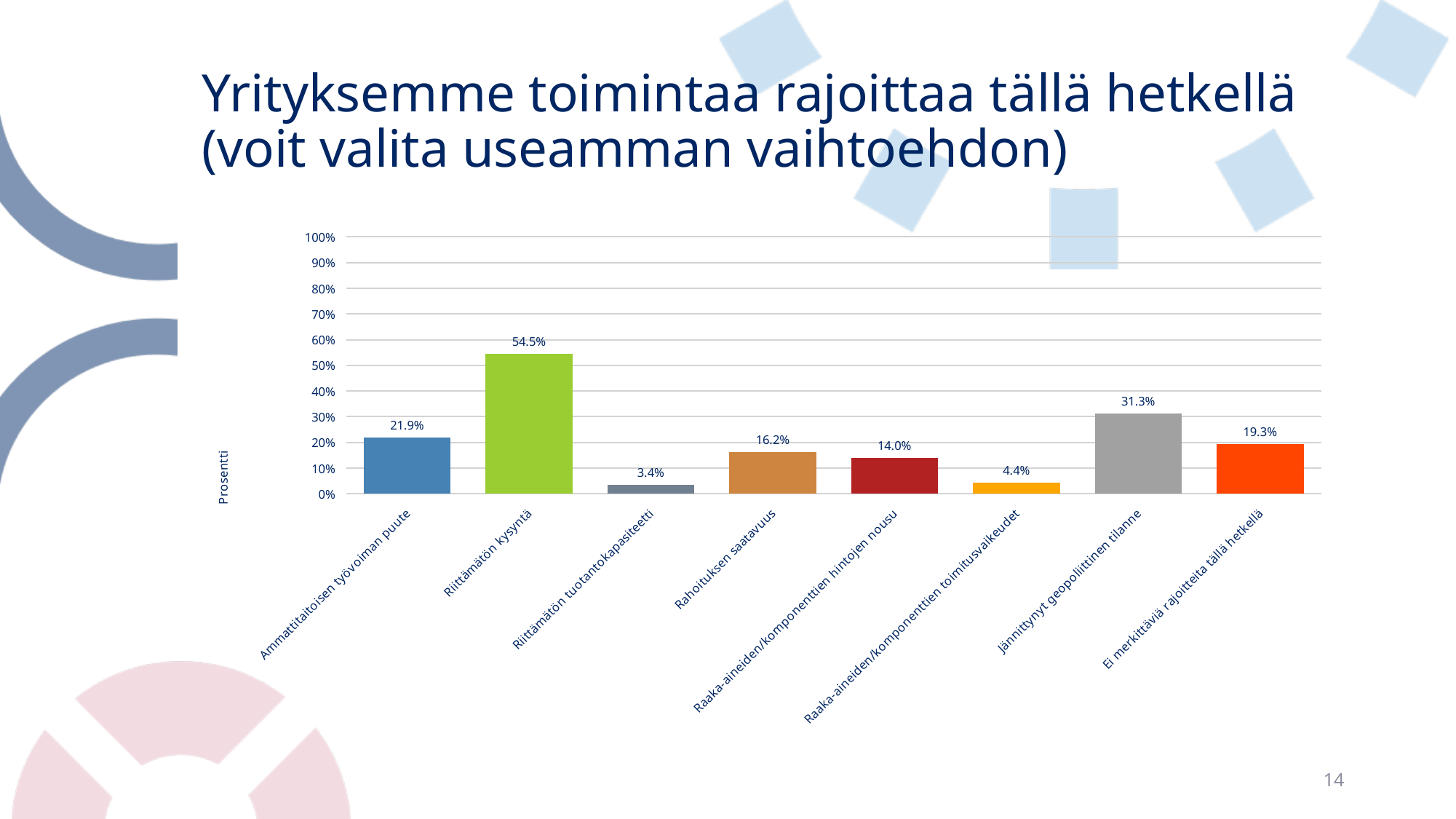
What is the value for Ei merkittäviä rajoitteita tällä hetkellä? 19.3% What is the label of the vertical axis? Prosentti What is the difference between Riittämätön kysyntä and Jännittynyt geopoliittinen tilanne? 23.2% Which is larger, Ammattitaitoisen työvoiman puute or Ei merkittäviä rajoitteita tällä hetkellä? Ammattitaitoisen työvoiman puute Which category has the lowest value? Riittämätön tuotantokapasiteetti Is the value for Raaka-aineiden/komponenttien hintojen nousu greater or less than 20%? less What is the value for Riittämätön kysyntä? 54.5% What is the value for Rahoituksen saatavuus? 16.2% What is the value for Jännittynyt geopoliittinen tilanne? 31.3% How many categories are shown on the x axis? 8 Which category has the highest value? Riittämätön kysyntä What kind of chart is shown on the slide? bar chart